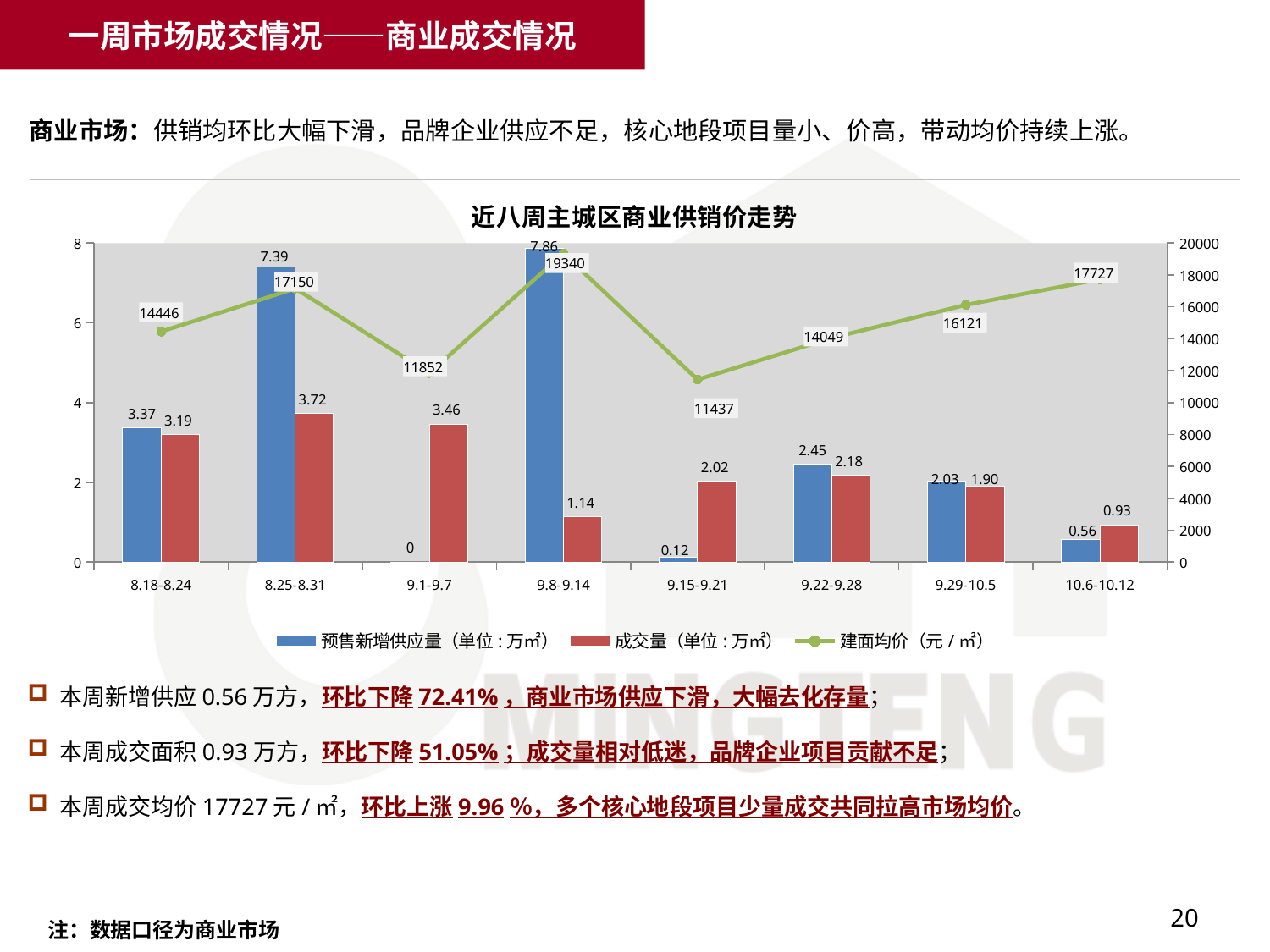
What is the 建面均价 value for 9.15-9.21? 11437 Which is larger for 9.22-9.28: 预售新增供应量 or 成交量? 预售新增供应量 Which week has the highest 建面均价? 9.8-9.14 What is the 成交量 value for 10.6-10.12? 0.93 What is the 预售新增供应量 value for 8.25-8.31? 7.39 How many weeks are shown on the x axis? 8 Which week has the lowest 成交量? 10.6-10.12 What kind of chart is this? Combined bar and line chart What is the title of the chart? 近八周主城区商业供销价走势 What is the difference between the 建面均价 for 10.6-10.12 and for 9.29-10.5? 1606 How many series does the legend list? 3 Which week has the highest 预售新增供应量? 9.8-9.14